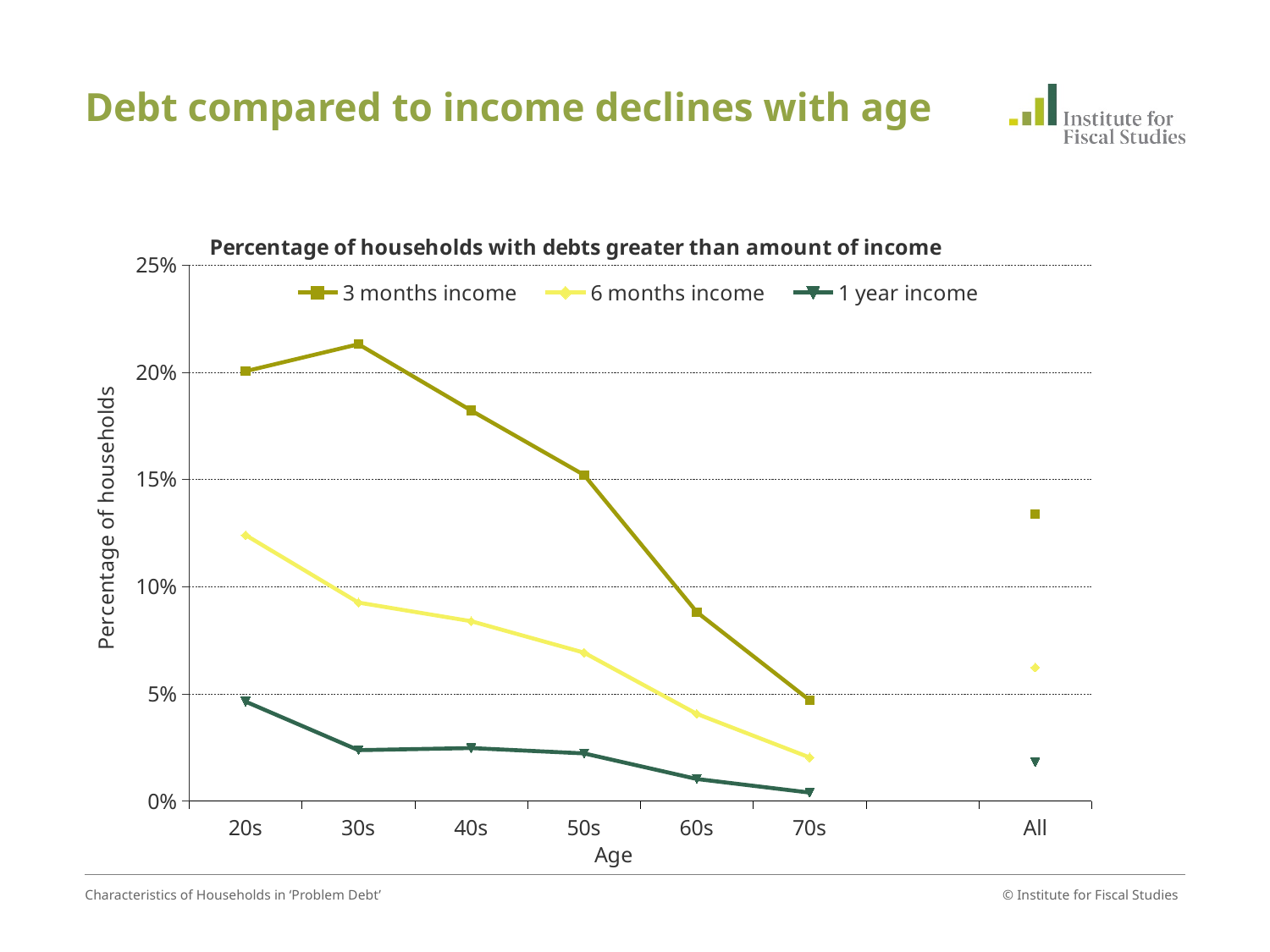
How many categories are shown on the x axis? 7 How many series does the legend list? 3 What kind of chart is shown on the slide? Line chart Is the value for 3 months income in the 60s age group greater or less than 10%? less Does the 6 months income series rise or fall from the 20s to the 70s age group? Fall Which age group has the lowest value for the 3 months income series? 70s Which age group has the highest value for the 1 year income series? 20s Is the value for 1 year income in the 30s age group greater or less than 5%? less Is the value for 3 months income in the 30s age group greater or less than 20%? greater Which age group has the highest value for the 3 months income series? 30s Which is larger: the 3 months income value for the 40s age group or the 6 months income value for the 20s age group? 3 months income for the 40s